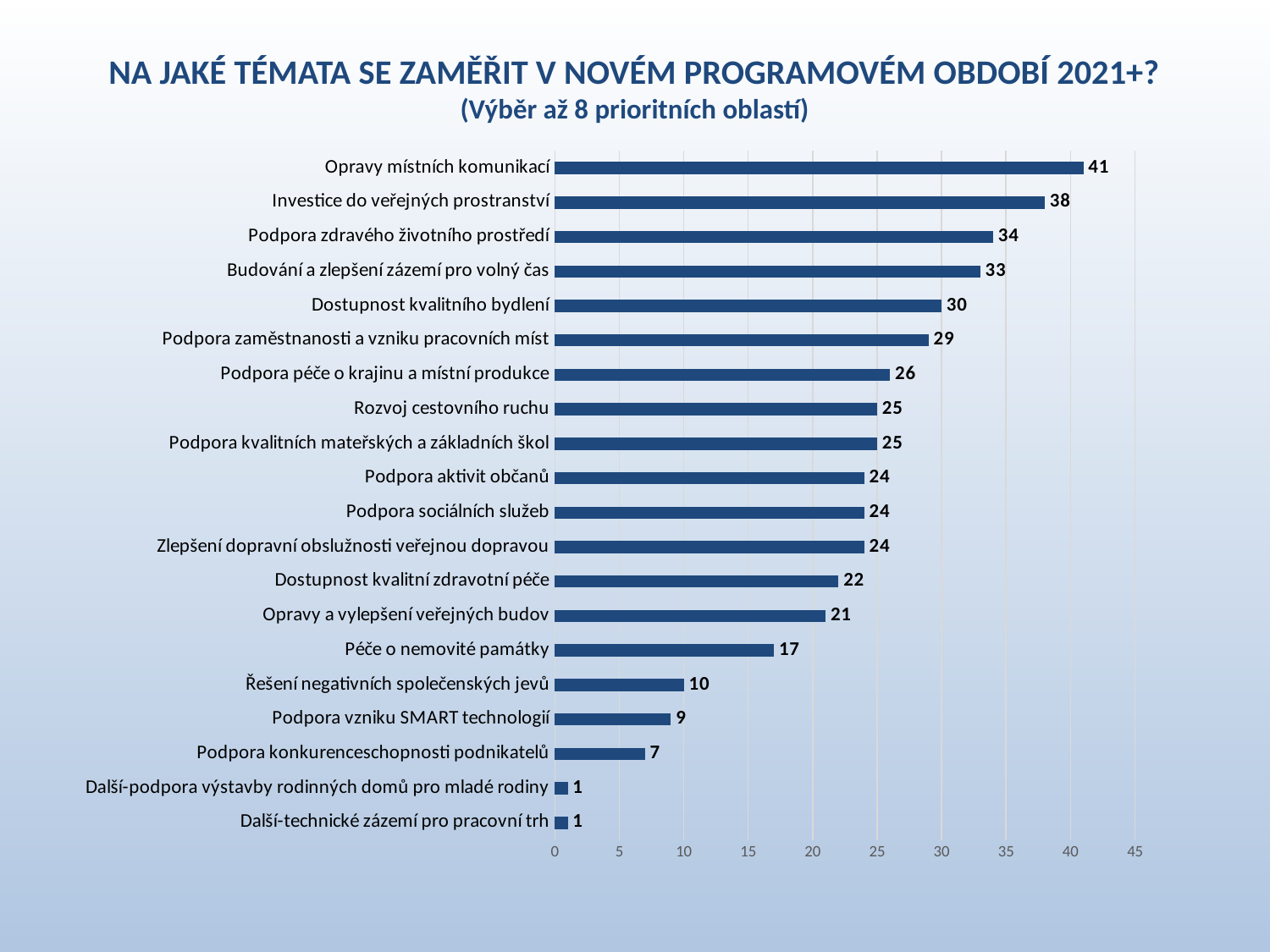
What is the difference between Péče o nemovité památky and Řešení negativních společenských jevů? 7 What is the maximum value shown on the horizontal axis? 45 What is the lowest value shown on the chart? 1 What value is shown for Podpora vzniku SMART technologií? 9 Which category has the highest value? Opravy místních komunikací Which is larger: Rozvoj cestovního ruchu or Podpora aktivit občanů? Rozvoj cestovního ruchu What is the difference between Investice do veřejných prostranství and Podpora zdravého životního prostředí? 4 What value is shown for Dostupnost kvalitního bydlení? 30 What kind of chart is shown on the slide? Bar chart How many categories are shown on the chart? 20 Which is larger: Podpora konkurenceschopnosti podnikatelů or Dostupnost kvalitní zdravotní péče? Dostupnost kvalitní zdravotní péče What value is shown for Opravy místních komunikací? 41